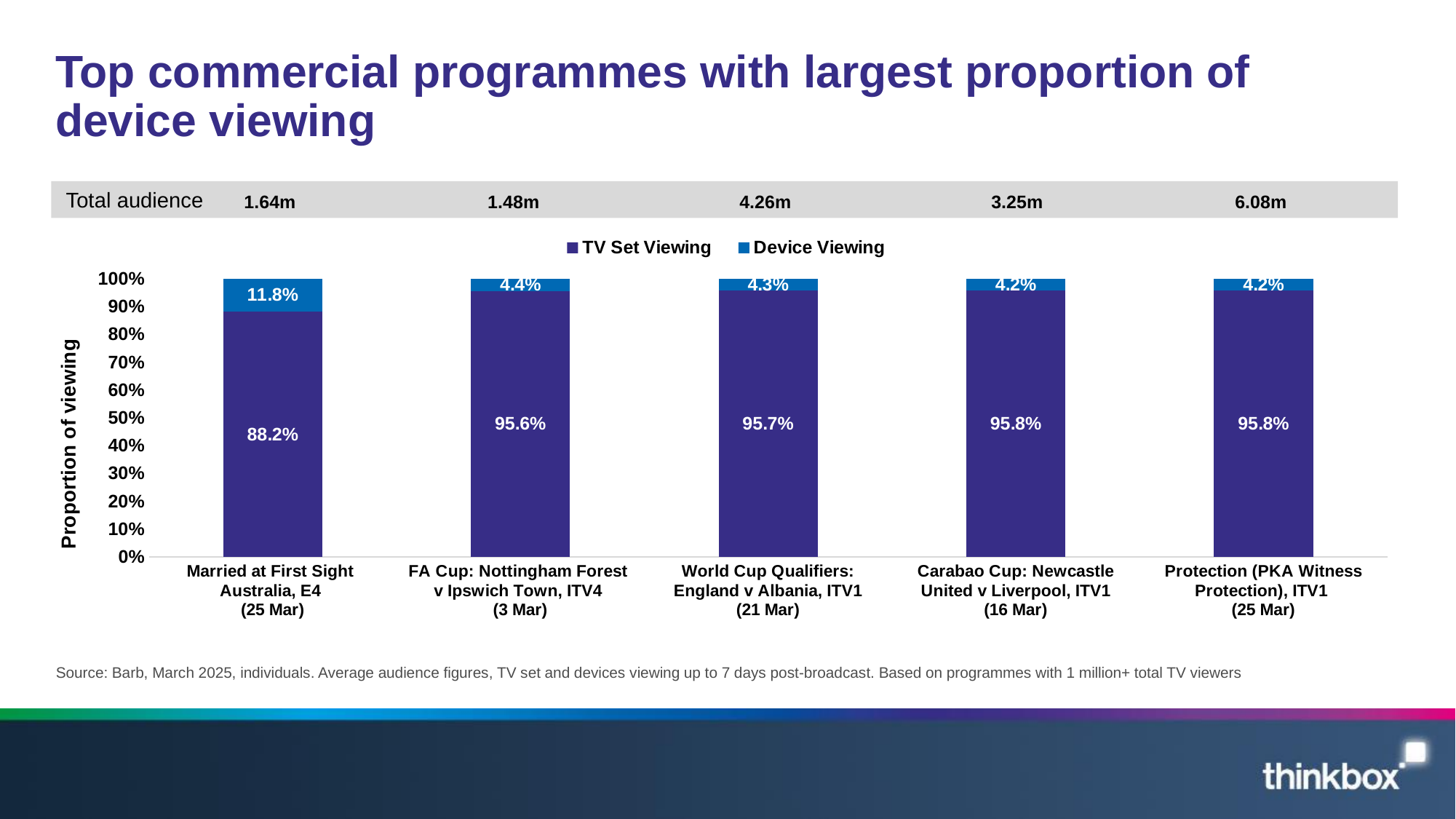
What is the Device Viewing proportion for FA Cup: Nottingham Forest v Ipswich Town, ITV4 (3 Mar)? 4.4% How many series does the legend list? 2 What is the TV Set Viewing proportion for World Cup Qualifiers: England v Albania, ITV1 (21 Mar)? 95.7% Which programme has the highest Device Viewing proportion? Married at First Sight Australia, E4 (25 Mar) Is the TV Set Viewing proportion for Married at First Sight Australia greater or less than 80%? greater What is the total audience shown for Protection (PKA Witness Protection), ITV1 (25 Mar)? 6.08m What is the Device Viewing proportion for Married at First Sight Australia, E4 (25 Mar)? 11.8% Which programme has the lowest TV Set Viewing proportion? Married at First Sight Australia, E4 (25 Mar) How many programmes are shown on the chart? 5 Which has a larger TV Set Viewing proportion: Married at First Sight Australia or Carabao Cup: Newcastle United v Liverpool? Carabao Cup: Newcastle United v Liverpool What is the difference in Device Viewing proportion between Married at First Sight Australia and FA Cup: Nottingham Forest v Ipswich Town? 7.4 percentage points What kind of chart is shown on the slide? Stacked bar chart